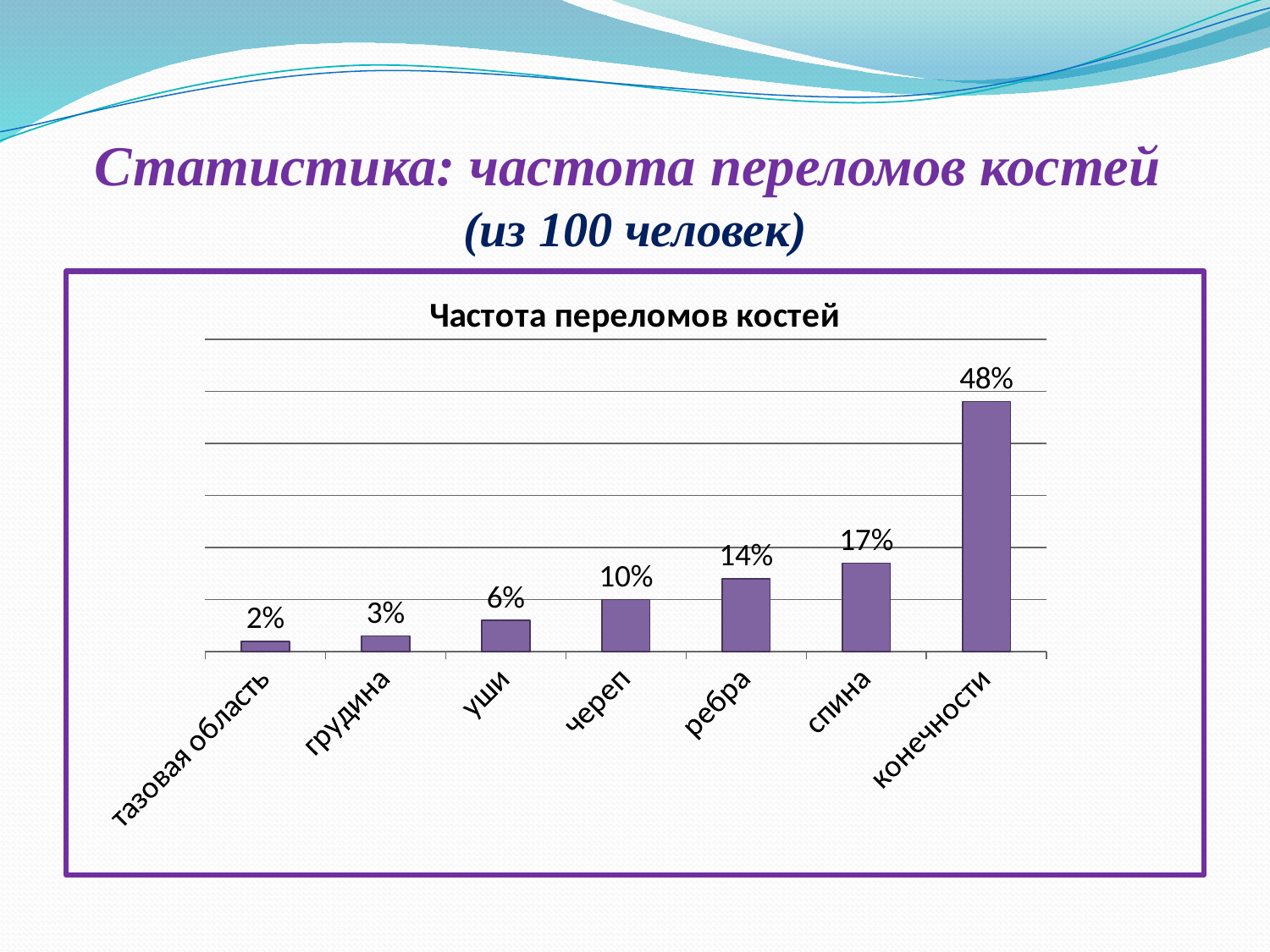
Do the values rise or fall from left to right along the x axis? rise Which category has the highest value? конечности What is the value for тазовая область? 2% What is the difference between the values for конечности and спина? 31% What is the title of the chart? Частота переломов костей What kind of chart is this? bar chart What is the difference between the values for череп and уши? 4% What is the value for конечности? 48% How many categories are shown on the x axis? 7 Which category has the lowest value? тазовая область What is the value for ребра? 14% Which is larger, the value for спина or the value for ребра? спина